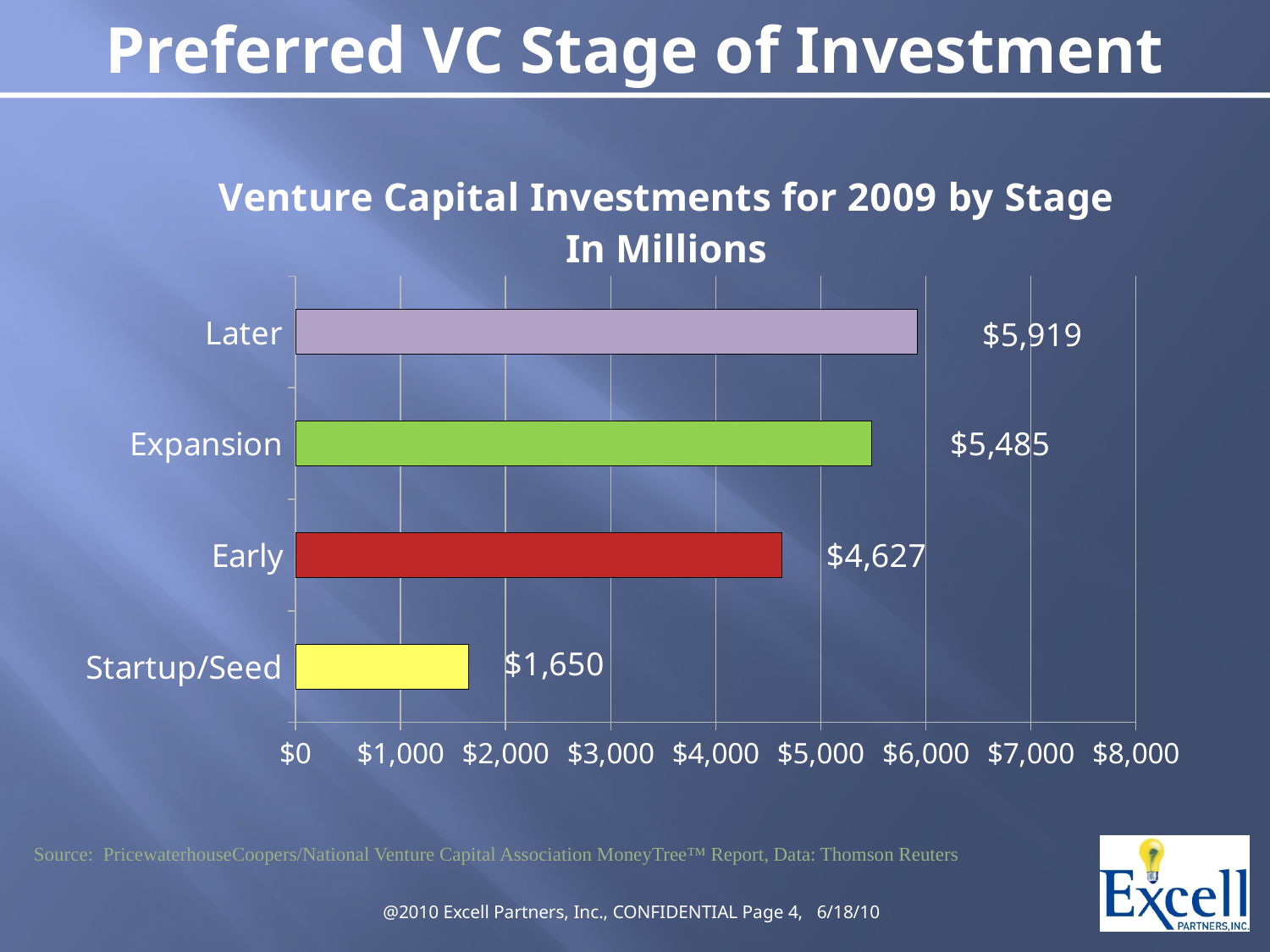
Which stage has the lowest investment value? Startup/Seed How many stages are shown in the chart? 4 What kind of chart is shown on the slide? Bar chart What is the title of the chart? Venture Capital Investments for 2009 by Stage In Millions What is the value for the Expansion stage? $5,485 What is the difference between the Early and Startup/Seed values? $2,977 What is the difference between the Later and Expansion values? $434 Which stage has the highest investment value? Later What is the value for the Early stage? $4,627 What is the value for the Later stage? $5,919 What is the value for Startup/Seed? $1,650 Which is larger, the value for Expansion or the value for Early? Expansion